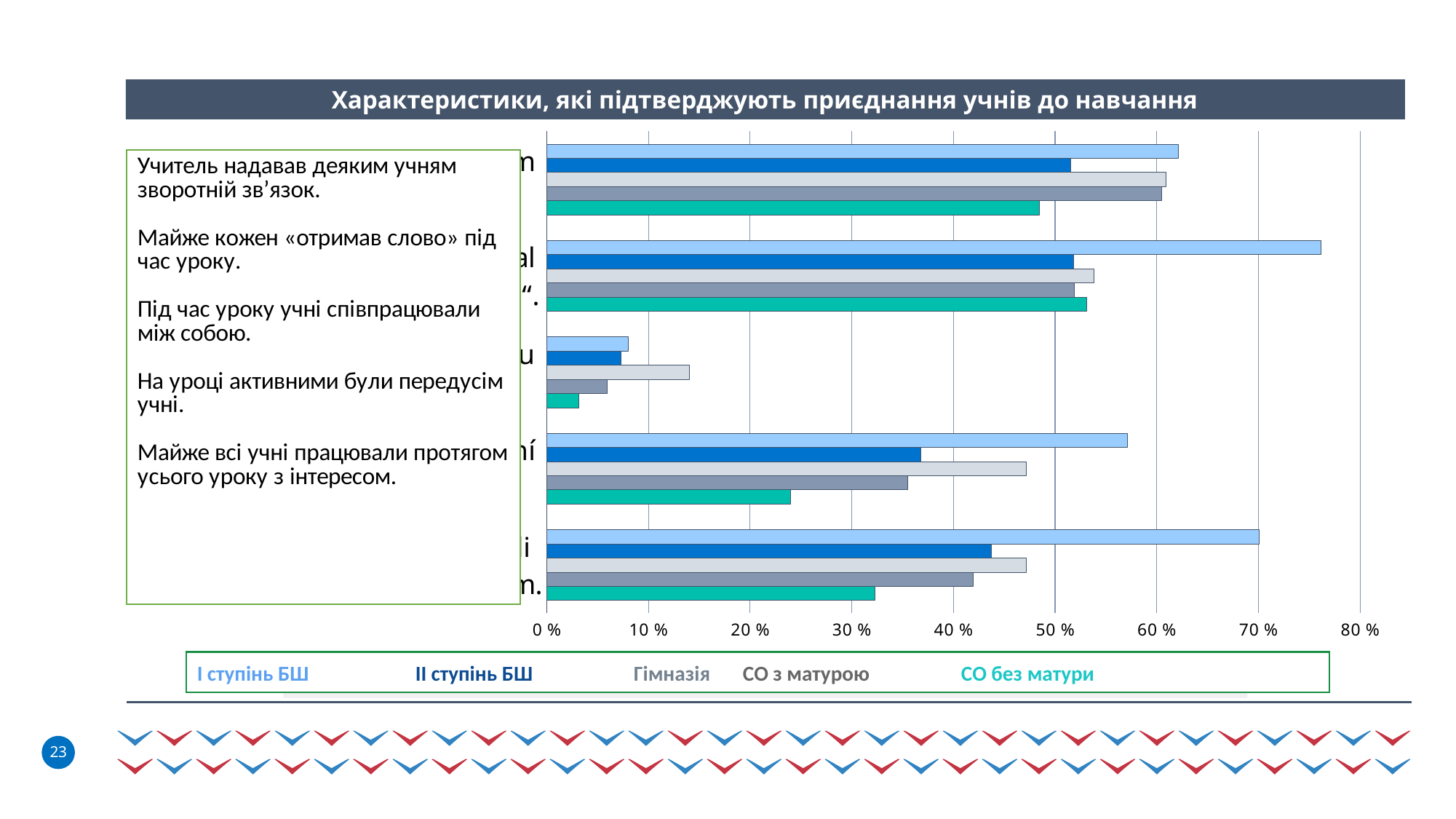
In the third group of bars from the top, which series has the lowest value? СО без матури How many series does the legend of the chart list? 5 In the third group of bars from the top, is the value for СО без матури greater or less than 10 %? less What is the highest value shown on the horizontal axis of the chart? 80 % What kind of chart is shown on the slide? bar chart In the bottom group of bars, which is larger: the value for І ступінь БШ or the value for ІІ ступінь БШ? І ступінь БШ What is the title of the chart? Характеристики, які підтверджують приєднання учнів до навчання In the second group of bars from the top, which series has the highest value? І ступінь БШ In the second group of bars from the top, is the value for І ступінь БШ greater or less than 70 %? greater How many groups of bars (categories) does the chart show? 5 In the fourth group of bars from the top, is the value for СО без матури greater or less than 30 %? less